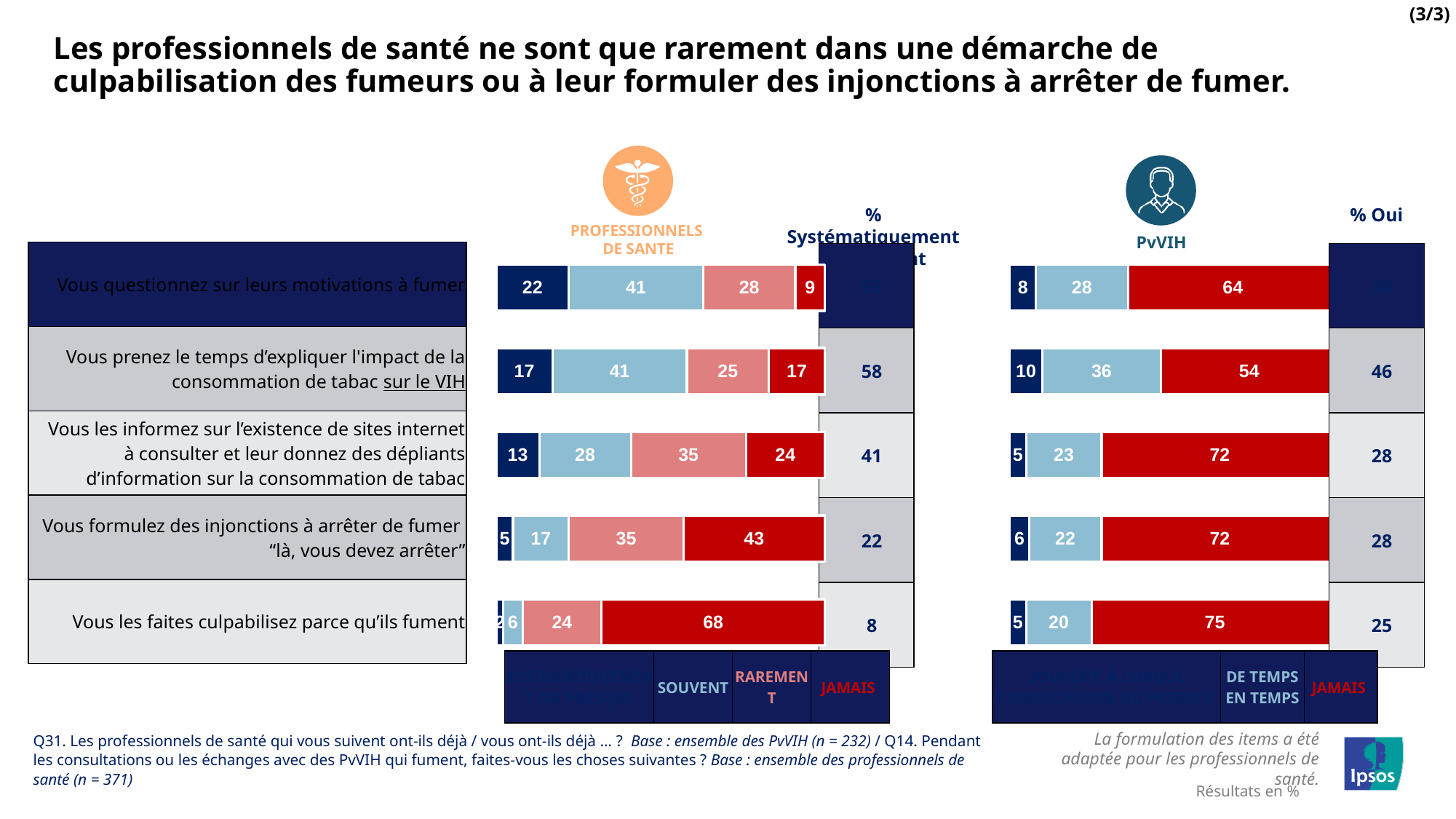
In the Professionnels de santé chart, what percentage answered 'Souvent' for 'Vous les informez sur l'existence de sites internet à consulter et leur donnez des dépliants d'information sur la consommation de tabac'? 28 In the Professionnels de santé chart, what percentage answered 'Jamais' for 'Vous les faites culpabilisez parce qu'ils fument'? 68 In the PvVIH chart, what percentage answered 'Jamais' for 'Vous formulez des injonctions à arrêter de fumer'? 72 In the Professionnels de santé chart, what is the '% Systématiquement + Souvent' value for 'Vous prenez le temps d'expliquer l'impact de la consommation de tabac sur le VIH'? 58 How many response categories does the legend of the PvVIH chart list? 3 In the Professionnels de santé chart, what is the difference between the 'Jamais' percentages for 'Vous formulez des injonctions à arrêter de fumer' and 'Vous prenez le temps d'expliquer l'impact de la consommation de tabac sur le VIH'? 26 In the PvVIH chart, what is the '% Oui' value for 'Vous les faites culpabilisez parce qu'ils fument'? 25 What type of chart is used for the Professionnels de santé data? Stacked bar chart In the PvVIH chart, is the 'De temps en temps' percentage higher for 'Vous prenez le temps d'expliquer l'impact de la consommation de tabac sur le VIH' or for 'Vous les faites culpabilisez parce qu'ils fument'? Vous prenez le temps d'expliquer l'impact de la consommation de tabac sur le VIH How many items (rows) are shown in the Professionnels de santé chart? 5 In the PvVIH chart, which item has the highest 'Jamais' percentage? Vous les faites culpabilisez parce qu'ils fument In the Professionnels de santé chart, which item has the lowest '% Systématiquement + Souvent' value? Vous les faites culpabilisez parce qu'ils fument